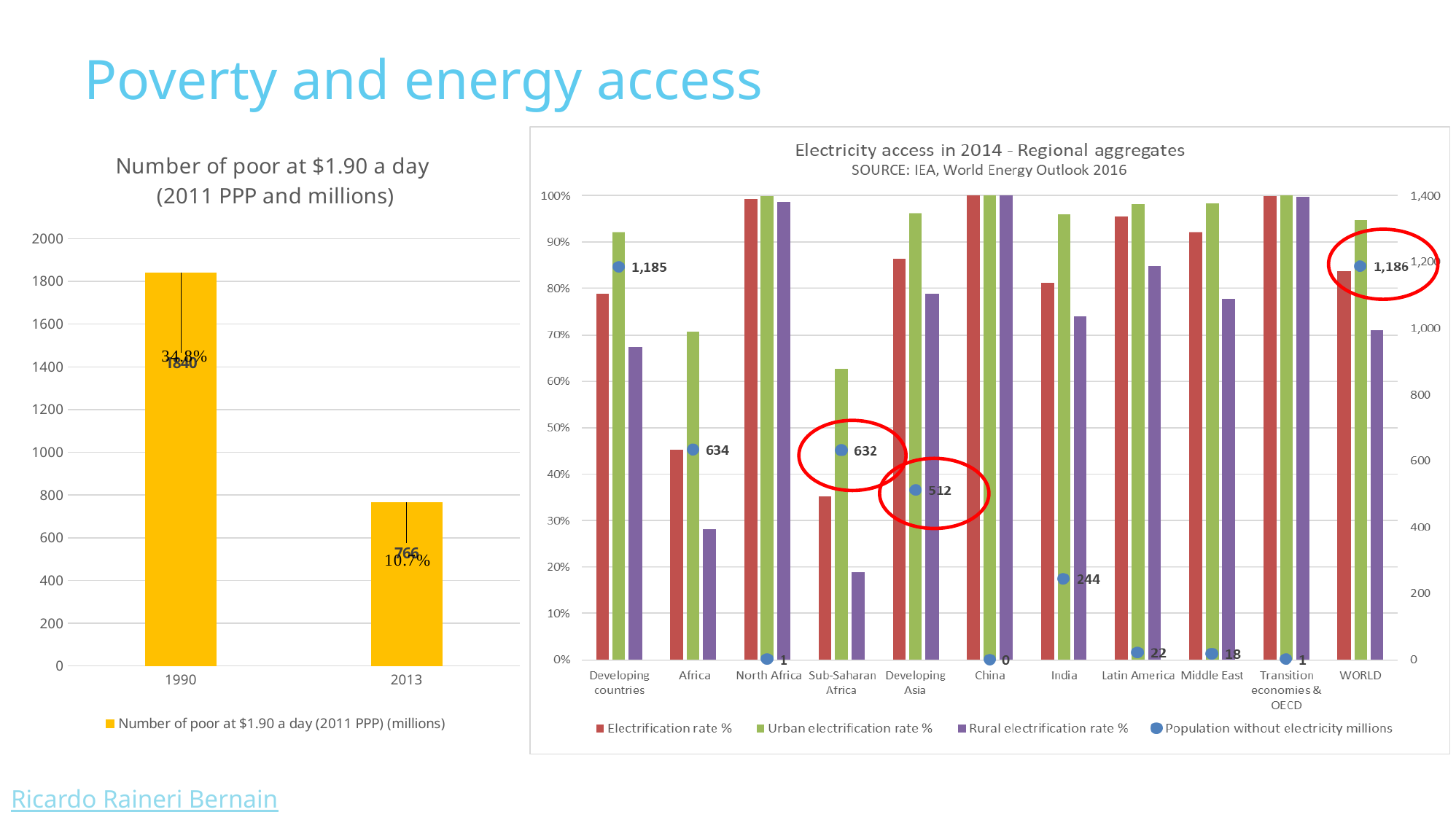
In the chart 'Number of poor at $1.90 a day', do the values rise or fall from 1990 to 2013? fall In the chart 'Number of poor at $1.90 a day', what is the value for 2013? 766 In the chart 'Electricity access in 2014 - Regional aggregates', what is the population without electricity (millions) for WORLD? 1,186 What kind of chart is 'Number of poor at $1.90 a day'? bar chart In the chart 'Number of poor at $1.90 a day', what is the value for 1990? 1840 In the chart 'Electricity access in 2014 - Regional aggregates', which has a larger population without electricity, Developing Asia or India? Developing Asia In the chart 'Electricity access in 2014 - Regional aggregates', what is the population without electricity (millions) for India? 244 In the chart 'Number of poor at $1.90 a day', what is the difference between the 1990 and 2013 values? 1074 How many series does the legend of the chart 'Electricity access in 2014 - Regional aggregates' list? 4 In the chart 'Electricity access in 2014 - Regional aggregates', which region has the lowest population without electricity? China In the chart 'Electricity access in 2014 - Regional aggregates', is the urban electrification rate for Africa greater or less than 60%? greater In the chart 'Electricity access in 2014 - Regional aggregates', what is the population without electricity (millions) for Sub-Saharan Africa? 632